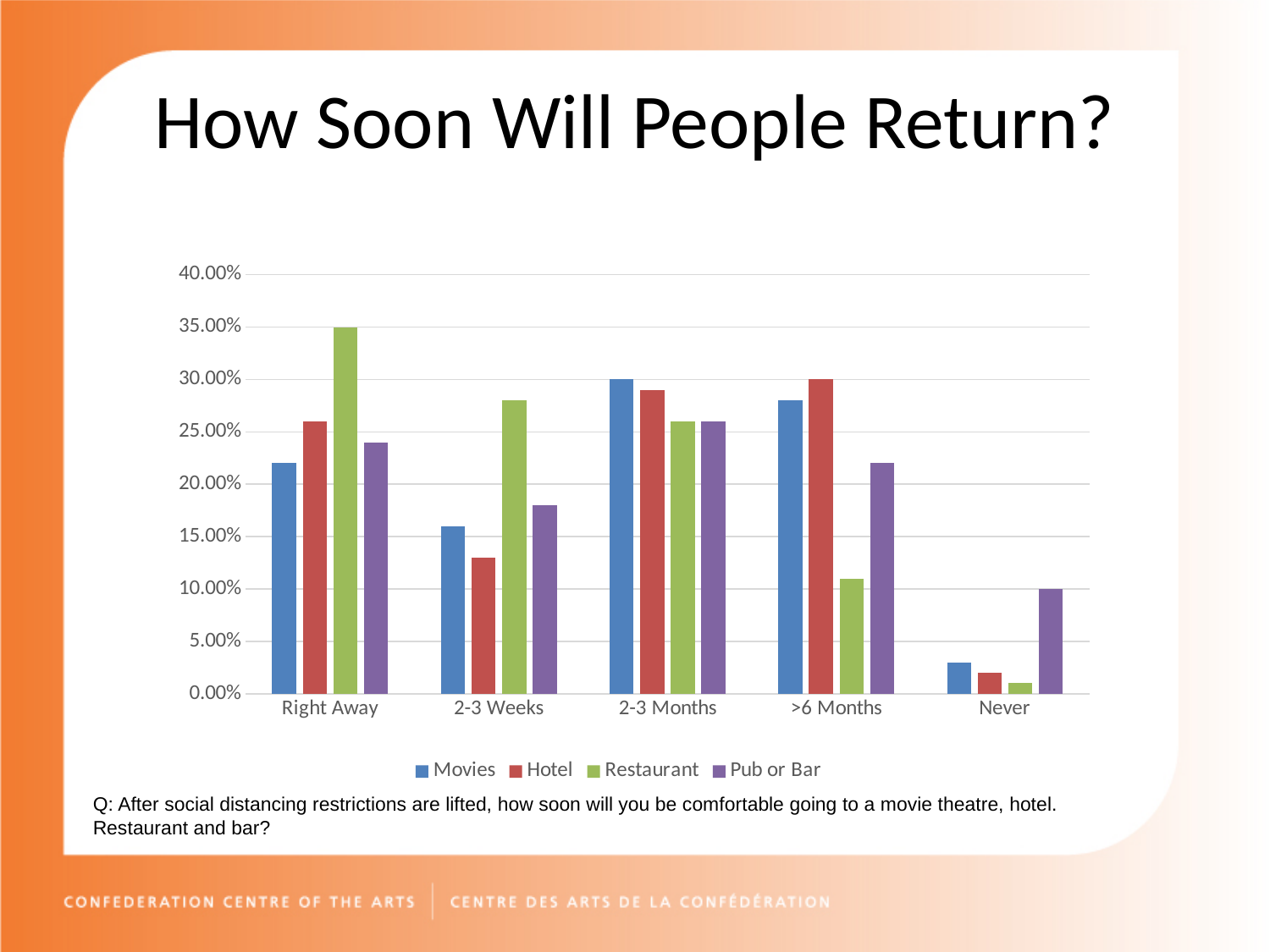
How many categories are shown along the x axis? 5 How many series does the legend list? 4 Is the value for Hotel in the 2-3 Weeks category greater or less than 15.00%? less In the Right Away category, which is larger: Restaurant or Hotel? Restaurant Do the Restaurant values rise or fall from Right Away to Never? fall What are the four series listed in the legend? Movies, Hotel, Restaurant, Pub or Bar Is the value for Movies in the Right Away category greater or less than 20.00%? greater In the Never category, which is larger: Pub or Bar or Movies? Pub or Bar What kind of chart is shown on the slide? bar chart Which category has the highest value for Restaurant? Right Away Is the value for Restaurant in the >6 Months category greater or less than 15.00%? less Which category has the lowest value for Movies? Never